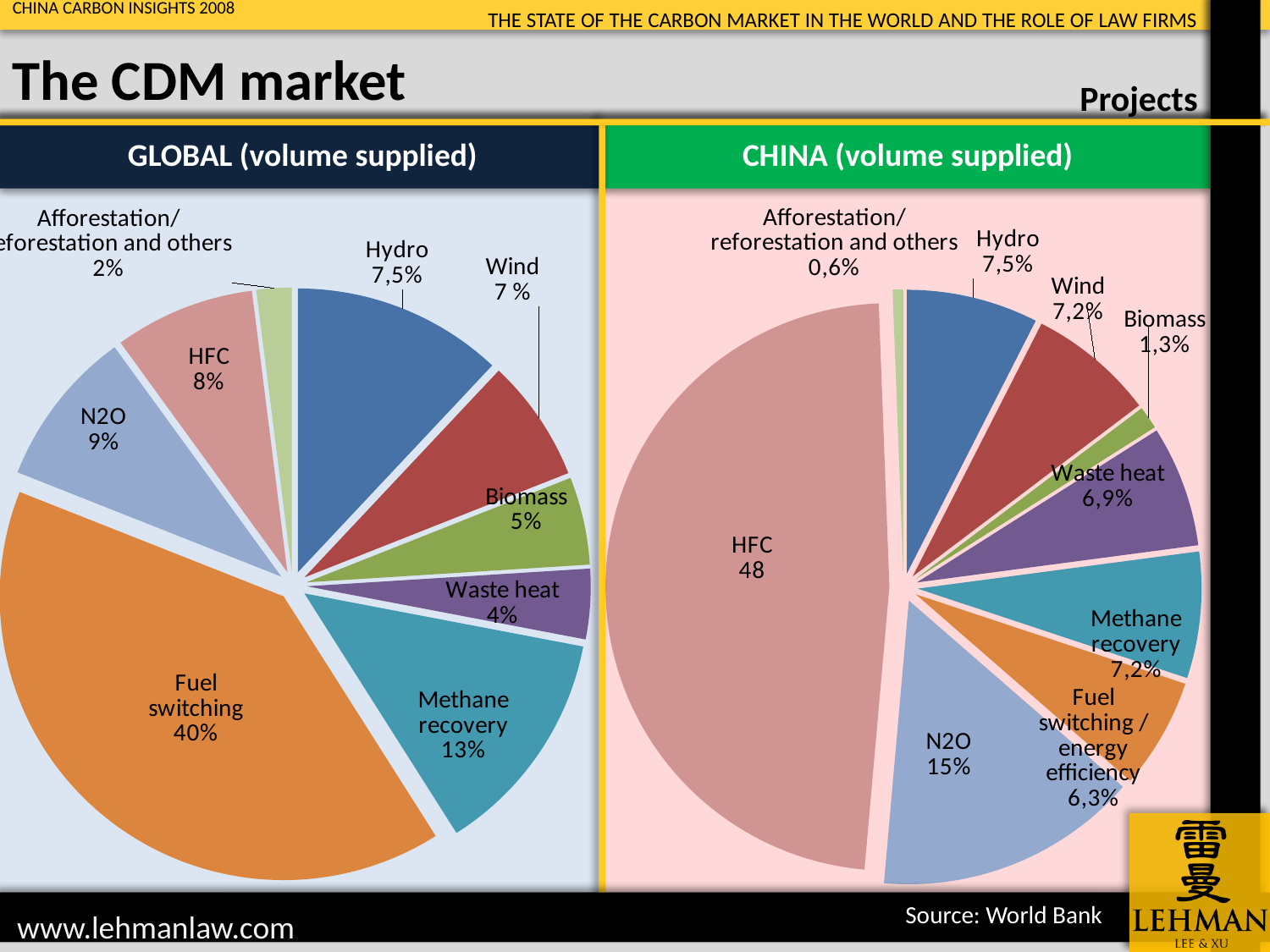
In the CHINA (volume supplied) chart, what is the value for N2O? 15% In the GLOBAL (volume supplied) chart, what share does Fuel switching have? 40% In the CHINA (volume supplied) chart, what is the value shown for HFC? 48 In the GLOBAL (volume supplied) chart, what is the difference between Fuel switching and Methane recovery? 27% In the GLOBAL (volume supplied) chart, which is larger, N2O or HFC? N2O In the GLOBAL (volume supplied) chart, what is the value for Methane recovery? 13% How many slices does the CHINA (volume supplied) pie chart have? 9 What type of chart is used for GLOBAL (volume supplied)? Pie chart In the CHINA (volume supplied) chart, which category has the largest slice? HFC In the CHINA (volume supplied) chart, what is the value for Afforestation/reforestation and others? 0,6% In the GLOBAL (volume supplied) chart, which category has the smallest slice? Afforestation/reforestation and others In the GLOBAL (volume supplied) chart, which category has the largest slice? Fuel switching